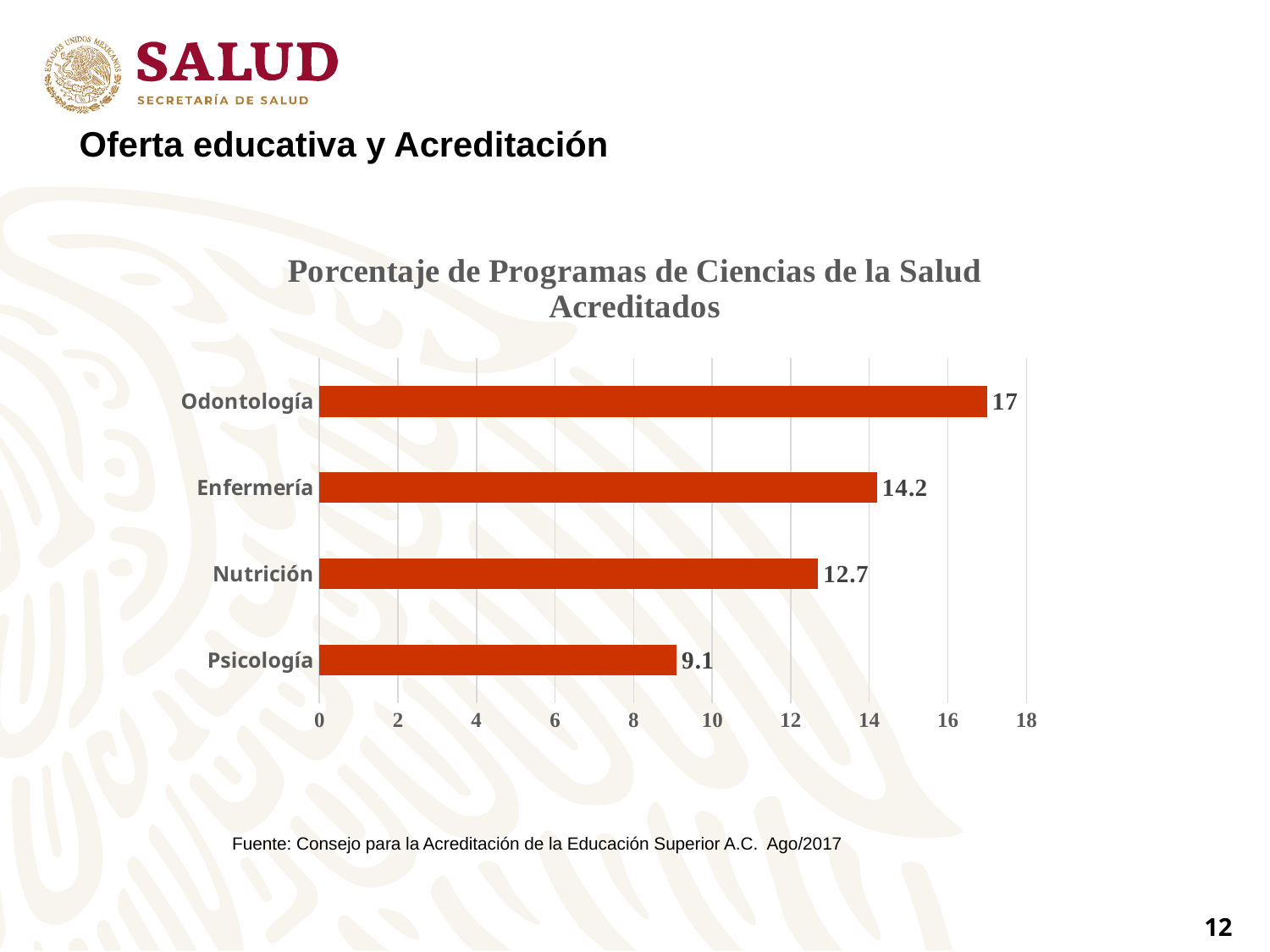
Which category has the lowest value? Psicología What is the value for Psicología? 9.1 Is the value for Psicología greater or less than 10? less What is the difference between the values for Odontología and Psicología? 7.9 What is the value for Nutrición? 12.7 Which category has the highest value? Odontología Which is larger, the value for Enfermería or the value for Nutrición? Enfermería What is the value for Odontología? 17 How many categories are shown in the chart? 4 What is the difference between the values for Enfermería and Nutrición? 1.5 What is the value for Enfermería? 14.2 What kind of chart is shown on the slide? bar chart